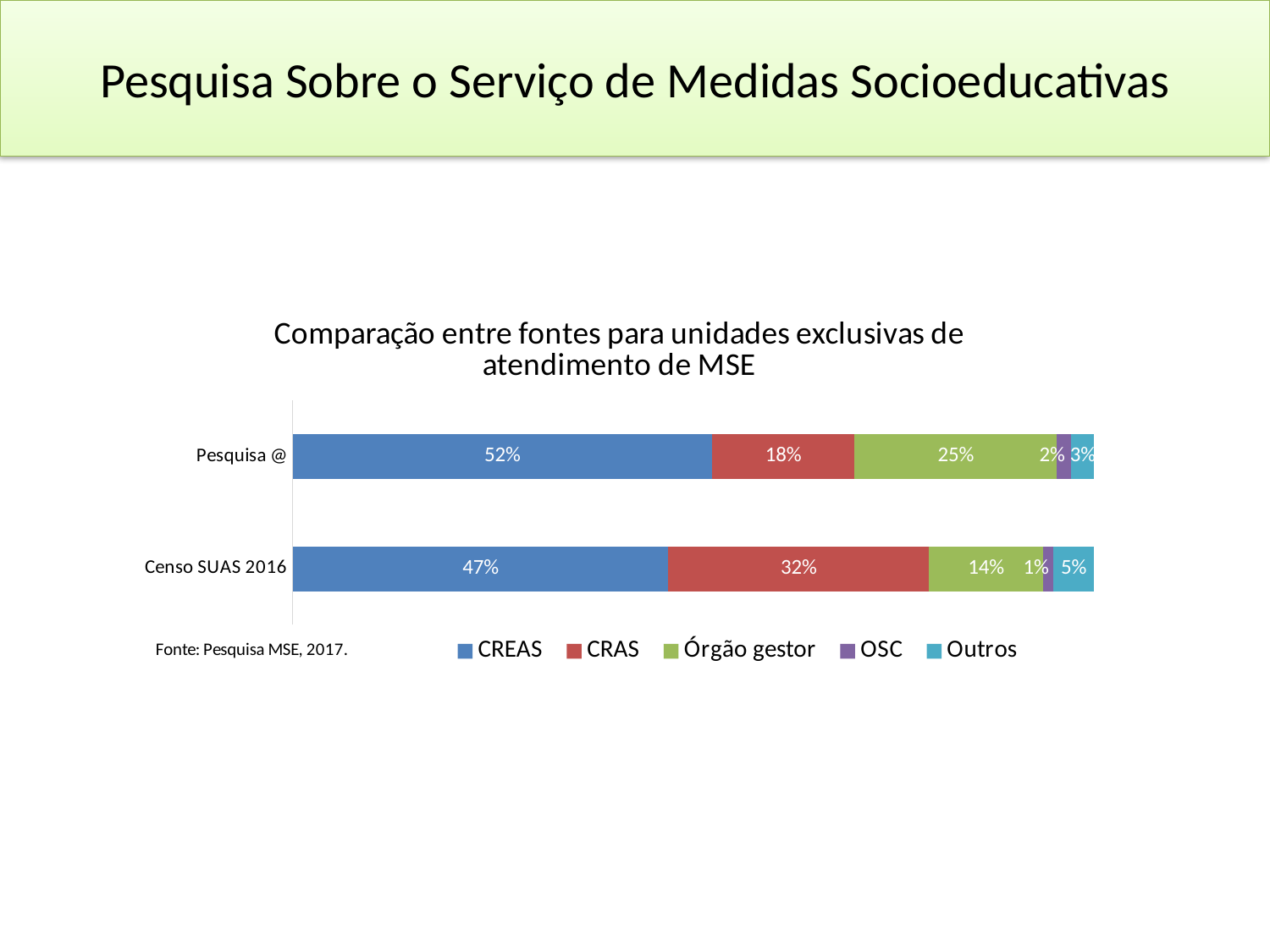
How many categories (bars) are shown in the chart? 2 What is the Órgão gestor value for Pesquisa @? 25% What kind of chart is shown on the slide? Stacked bar chart Which series has the largest share in the Censo SUAS 2016 bar? CREAS What is the CRAS value for Censo SUAS 2016? 32% How many series does the legend list? 5 What is the OSC value for Pesquisa @? 2% Which has a larger Órgão gestor value, Pesquisa @ or Censo SUAS 2016? Pesquisa @ What is the difference between the CRAS values for Censo SUAS 2016 and Pesquisa @? 14% What is the Outros value for Censo SUAS 2016? 5% What is the CREAS value for Pesquisa @? 52% Which series has the smallest share in the Censo SUAS 2016 bar? OSC